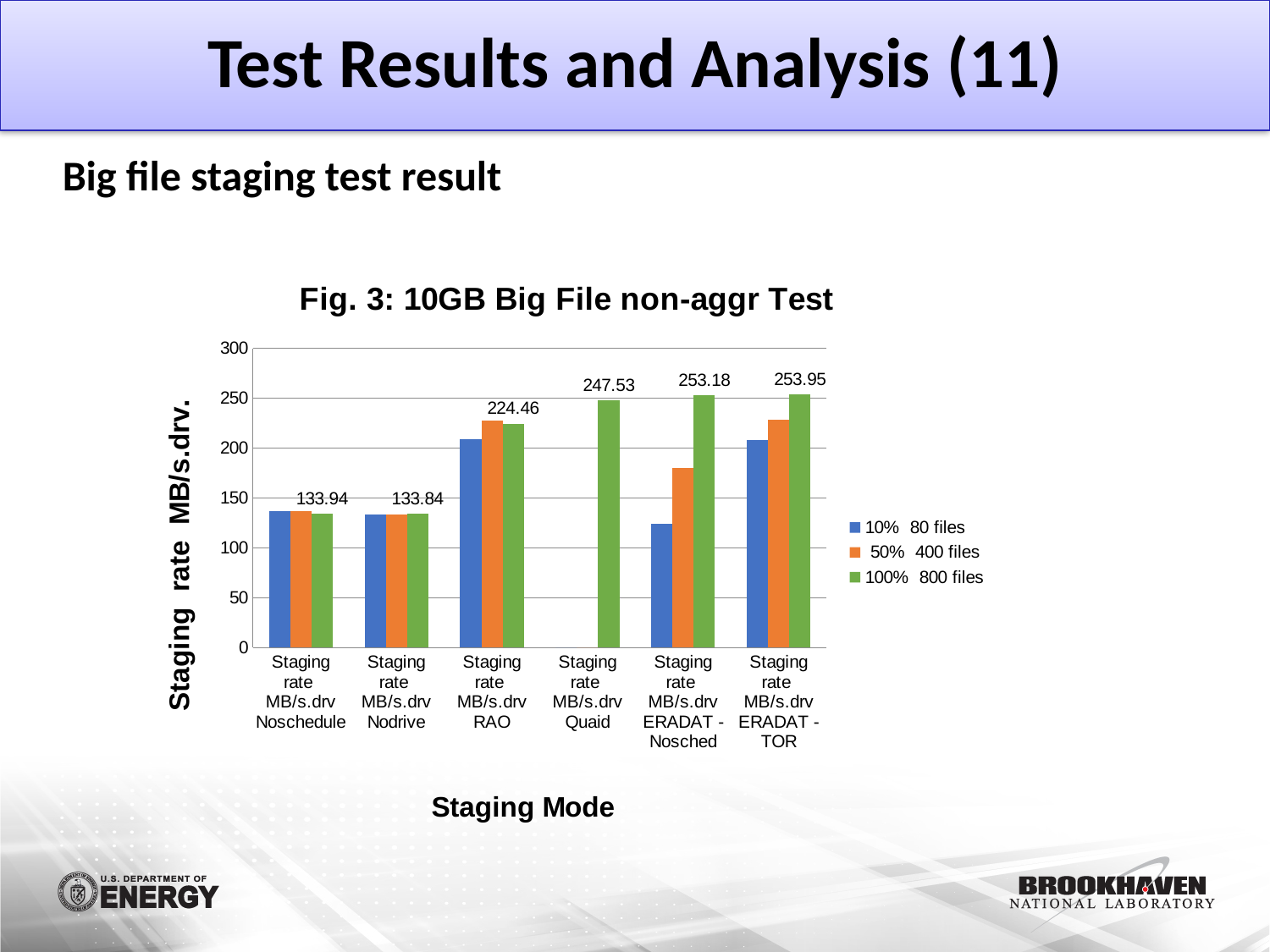
In Fig. 3, is the 10% 80 files value for ERADAT - Nosched greater or less than 150? less In Fig. 3, which is larger for the 10% 80 files series: RAO or ERADAT - Nosched? RAO In Fig. 3, which staging mode has the highest value in the 100% 800 files series? ERADAT - TOR In Fig. 3, how much higher is the 100% 800 files value for RAO than for Noschedule? 90.52 In Fig. 3, what is the value of the 100% 800 files series for ERADAT - TOR? 253.95 In Fig. 3, is the 50% 400 files value for RAO greater or less than 200? greater In Fig. 3, which staging mode has the lowest value in the 100% 800 files series? Nodrive In Fig. 3, what is the value of the 100% 800 files series for the Quaid staging mode? 247.53 In Fig. 3, what is the value of the 100% 800 files series for the RAO staging mode? 224.46 How many staging modes are shown on the x axis of Fig. 3? 6 In Fig. 3, what is the difference between the 100% 800 files values for ERADAT - TOR and ERADAT - Nosched? 0.77 How many series does the legend of Fig. 3 list? 3